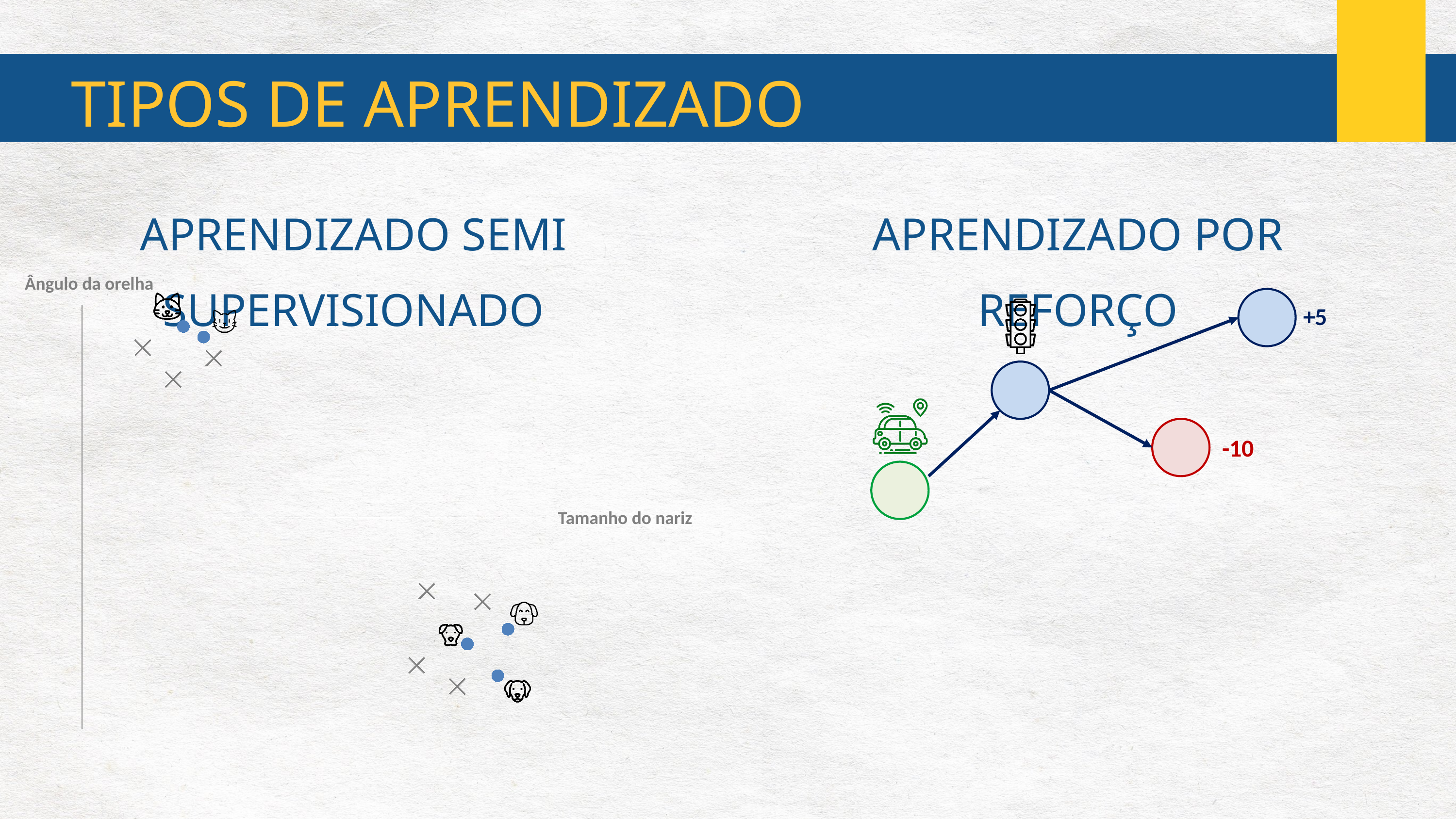
In the scatter plot on the left, how many distinct clusters of points are shown? 2 What is the label of the vertical axis of the scatter plot on the left? Ângulo da orelha In the scatter plot on the left, which cluster has the higher 'Ângulo da orelha' values: the cluster with cat icons or the cluster with dog icons? the cluster with cat icons In the scatter plot on the left, how many X marks are in the lower-right cluster (near the dog icons)? 4 What kind of chart is shown on the left side of the slide under 'Aprendizado semi supervisionado'? scatter plot In the 'Aprendizado por reforço' diagram on the right, which outcome has the larger value: the blue circle or the red circle? the blue circle In the 'Aprendizado por reforço' diagram on the right, what value is written next to the red circle? -10 What is the label of the horizontal axis of the scatter plot on the left? Tamanho do nariz In the scatter plot on the left, which cluster has the larger 'Tamanho do nariz' values: the cluster with cat icons or the cluster with dog icons? the cluster with dog icons In the 'Aprendizado por reforço' diagram on the right, what value is written next to the blue circle at the top right? +5 In the scatter plot on the left, how many blue dots are in the lower-right cluster (near the dog icons)? 3